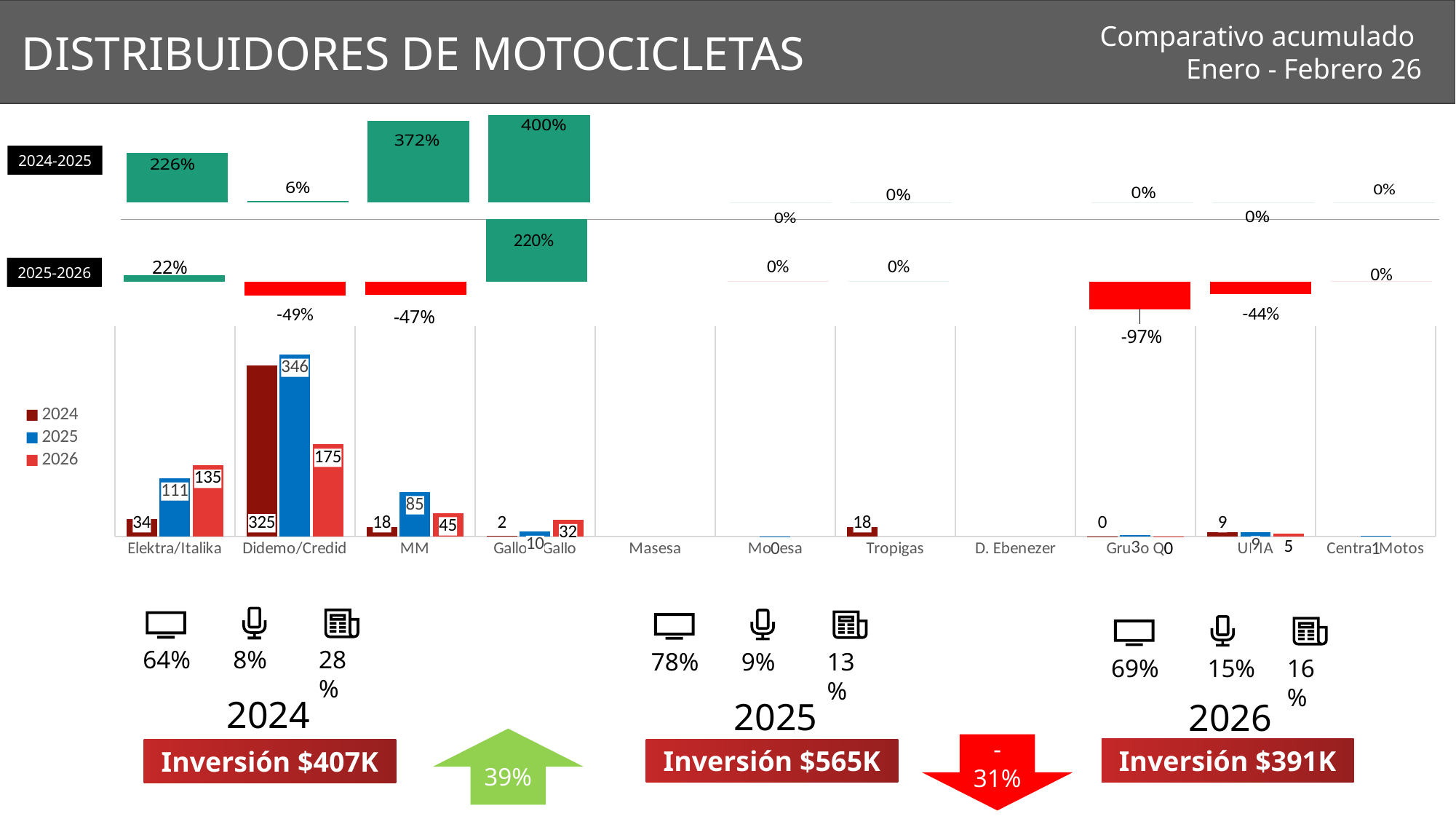
In the 2025-2026 change chart, what is the percentage shown for Didemo/Credid? -49% In the bar chart, which is larger for MM: the 2025 value or the 2026 value? 2025 In the bar chart, what is the 2024 value for MM? 18 In the bar chart, what is the difference between the 2025 and 2026 values for Didemo/Credid? 171 In the bar chart, what is the 2025 value for Didemo/Credid? 346 In the 2024-2025 change chart, what is the percentage shown for Gallo Gallo? 400% In the bar chart, which distributor has the highest 2025 value? Didemo/Credid In the 2025-2026 change chart, what is the percentage shown for MM? -47% In the bar chart, do the values for Elektra/Italika rise or fall from 2024 to 2026? Rise How many series does the legend of the bar chart list? 3 What kind of chart is the main chart showing values per distributor? Bar chart In the bar chart, what is the 2026 value for Elektra/Italika? 135